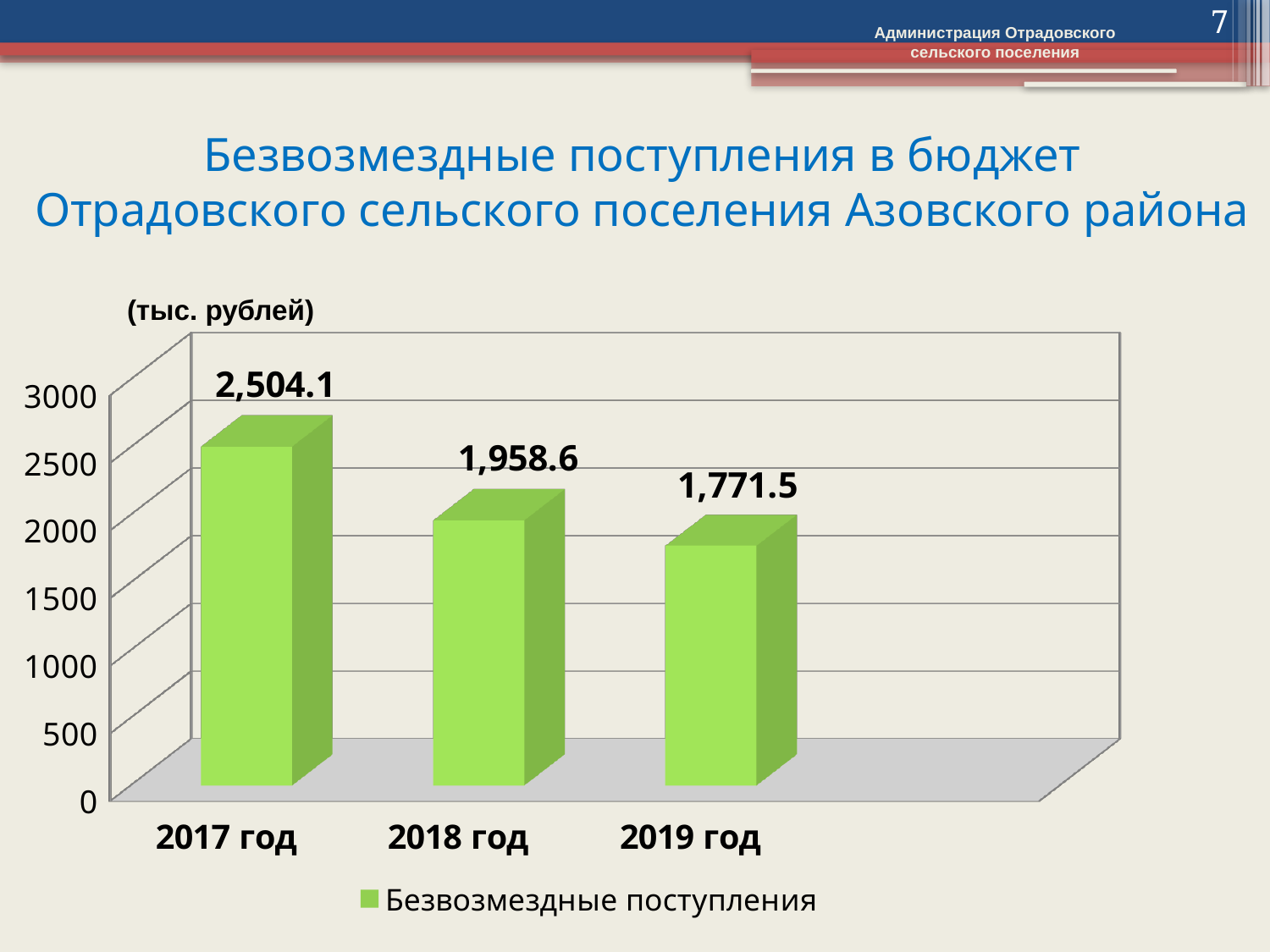
What kind of chart is shown on the slide? bar chart What is the difference between the values for 2018 год and 2019 год? 187.1 How many years are shown on the x axis? 3 Do the values rise or fall from 2017 год to 2019 год? fall Which year has the highest value? 2017 год Which year has the lowest value? 2019 год What is the value for 2019 год? 1,771.5 What is the value for 2018 год? 1,958.6 Is the value for 2017 год greater or less than 2500? greater What is the value for 2017 год? 2,504.1 What is the difference between the values for 2017 год and 2018 год? 545.5 Which is larger, the value for 2018 год or the value for 2019 год? 2018 год